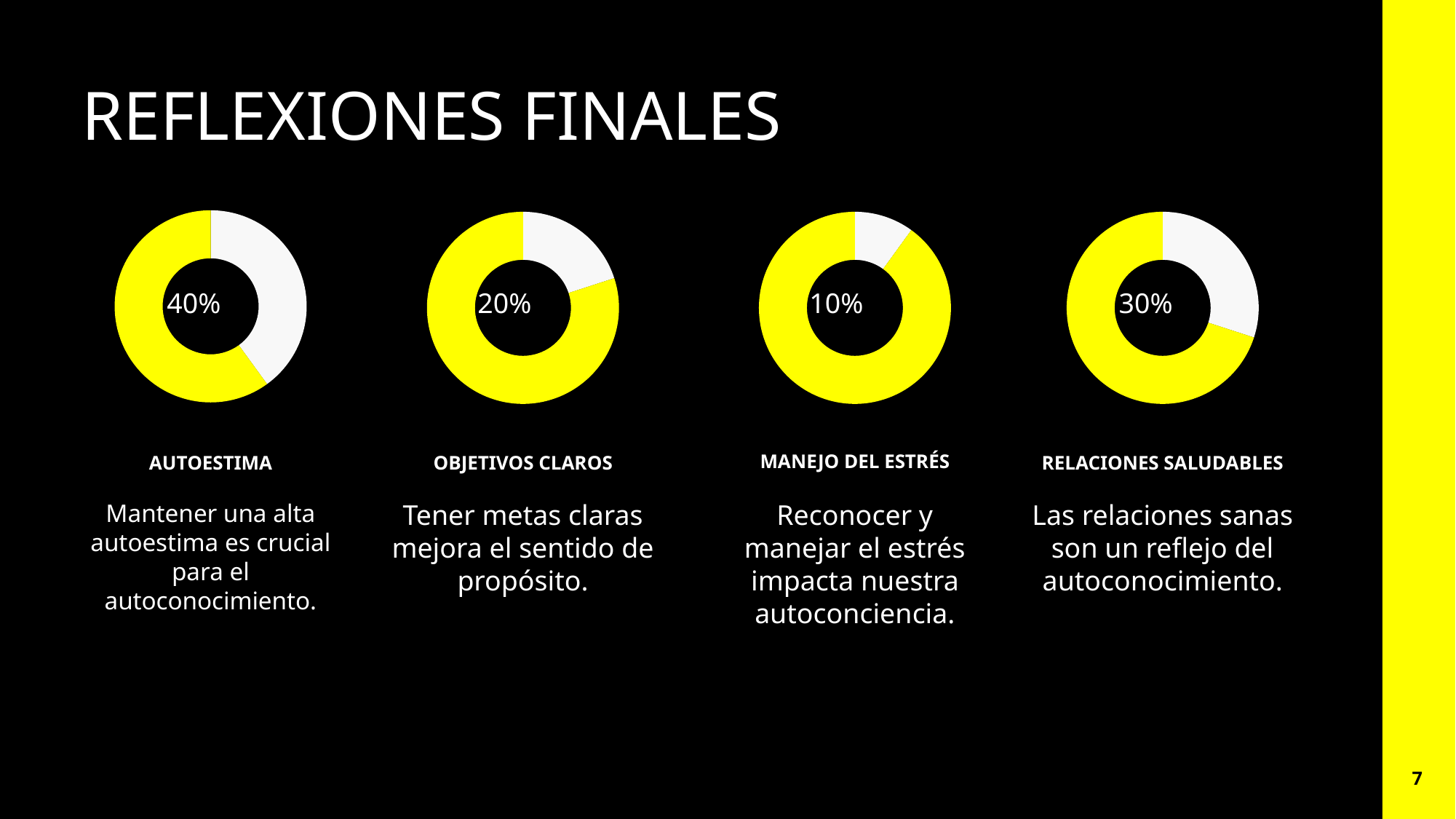
What percentage is shown in the centre of the AUTOESTIMA donut chart? 40% What percentage is shown in the centre of the OBJETIVOS CLAROS donut chart? 20% What is the difference between the percentage shown for AUTOESTIMA and the percentage shown for MANEJO DEL ESTRÉS? 30% What percentage is shown in the centre of the MANEJO DEL ESTRÉS donut chart? 10% Which of the four donut charts shows the highest percentage? AUTOESTIMA What is the difference between the percentage shown for RELACIONES SALUDABLES and the percentage shown for OBJETIVOS CLAROS? 10% What kind of chart is used for each of the four percentages on the slide? Donut chart How many donut charts are on the slide? 4 What is the title of the slide containing the four donut charts? REFLEXIONES FINALES What percentage is shown in the centre of the RELACIONES SALUDABLES donut chart? 30% Which shows a larger percentage, the OBJETIVOS CLAROS chart or the RELACIONES SALUDABLES chart? RELACIONES SALUDABLES Which of the four donut charts shows the lowest percentage? MANEJO DEL ESTRÉS